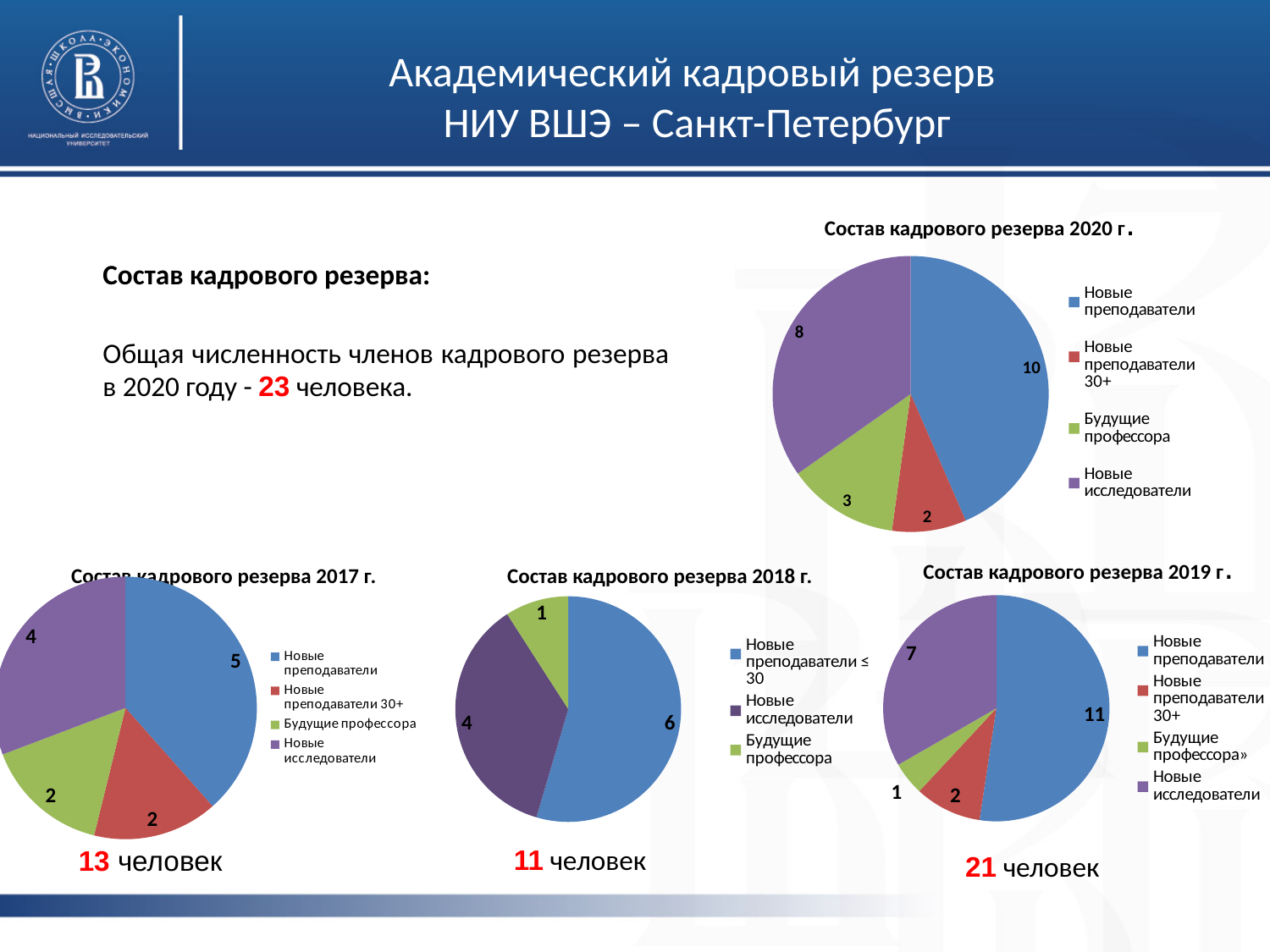
In the chart 'Состав кадрового резерва 2017 г.', which category has the largest slice? Новые преподаватели In the chart 'Состав кадрового резерва 2020 г.', what is the difference between 'Новые преподаватели' and 'Новые исследователи'? 2 What type of chart is 'Состав кадрового резерва 2019 г.'? Pie chart How many entries does the legend of the chart 'Состав кадрового резерва 2020 г.' list? 4 In the chart 'Состав кадрового резерва 2020 г.', what share of the total does 'Новые исследователи' (8 of 23) represent, rounded to the nearest whole percent? 35% In the chart 'Состав кадрового резерва 2020 г.', what is the value for 'Новые преподаватели'? 10 In the chart 'Состав кадрового резерва 2020 г.', which category has the smallest slice? Новые преподаватели 30+ In the chart 'Состав кадрового резерва 2017 г.', what is the value for 'Будущие профессора'? 2 In the chart 'Состав кадрового резерва 2018 г.', what is the value for 'Новые исследователи'? 4 How many categories does the chart 'Состав кадрового резерва 2018 г.' show? 3 In the chart 'Состав кадрового резерва 2019 г.', what is the value for 'Будущие профессора»'? 1 In the chart 'Состав кадрового резерва 2019 г.', which is larger: 'Новые преподаватели' or 'Новые исследователи'? Новые преподаватели